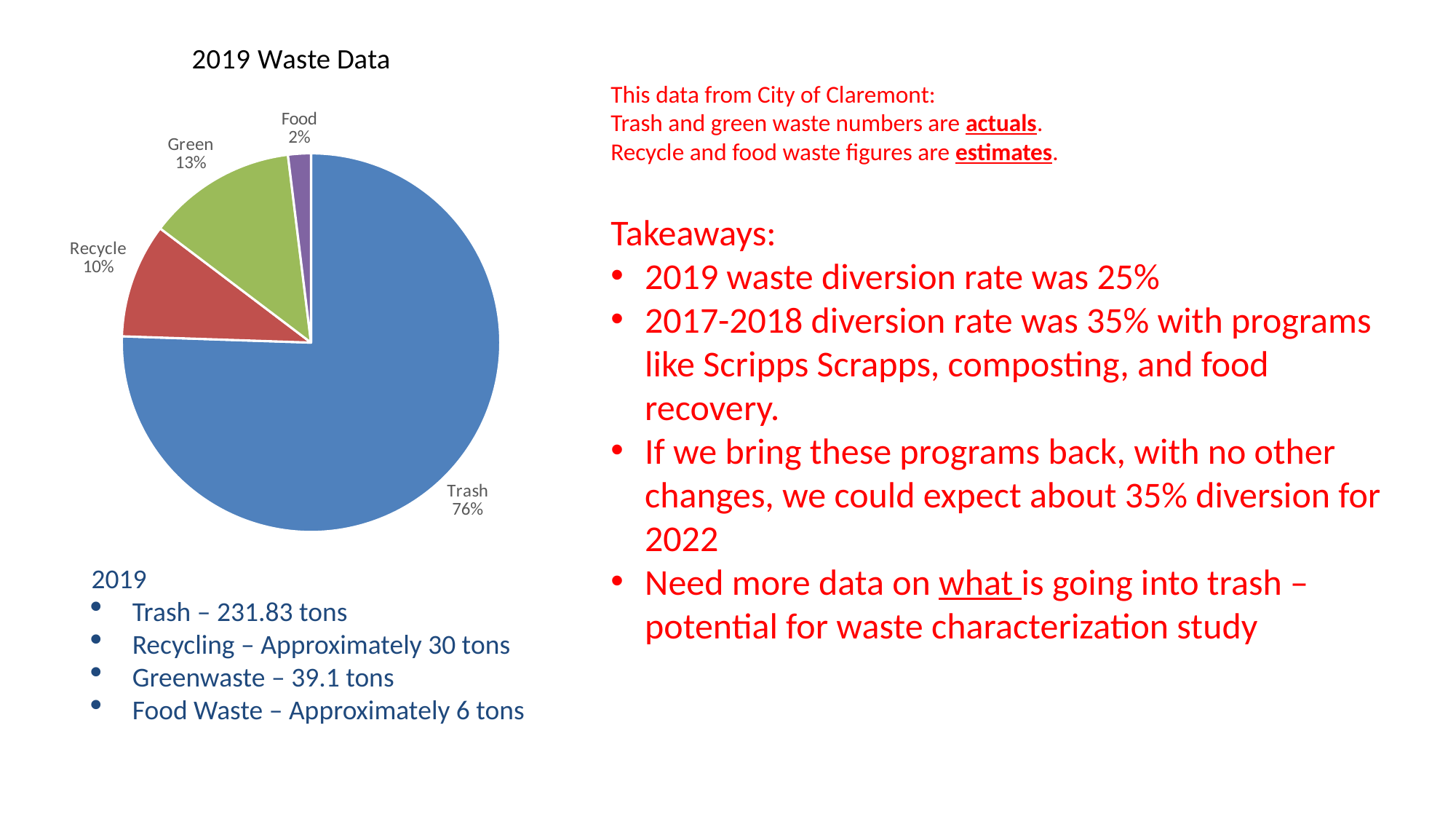
What is the title of the chart on the slide? 2019 Waste Data Which slice is larger in the pie chart, Green or Recycle? Green What percentage is shown for Recycle in the 2019 Waste Data pie chart? 10% What is the difference in percentage points between the Trash and Green slices? 63 What percentage is shown for Green in the 2019 Waste Data pie chart? 13% What kind of chart is shown on the slide? Pie chart What percentage is shown for Food in the 2019 Waste Data pie chart? 2% Which category has the largest slice in the 2019 Waste Data pie chart? Trash What share of the pie does Trash take in the 2019 Waste Data chart? 76% What colour is the Trash slice in the pie chart? Blue Which category has the smallest slice in the 2019 Waste Data pie chart? Food How many slices does the 2019 Waste Data pie chart have? 4